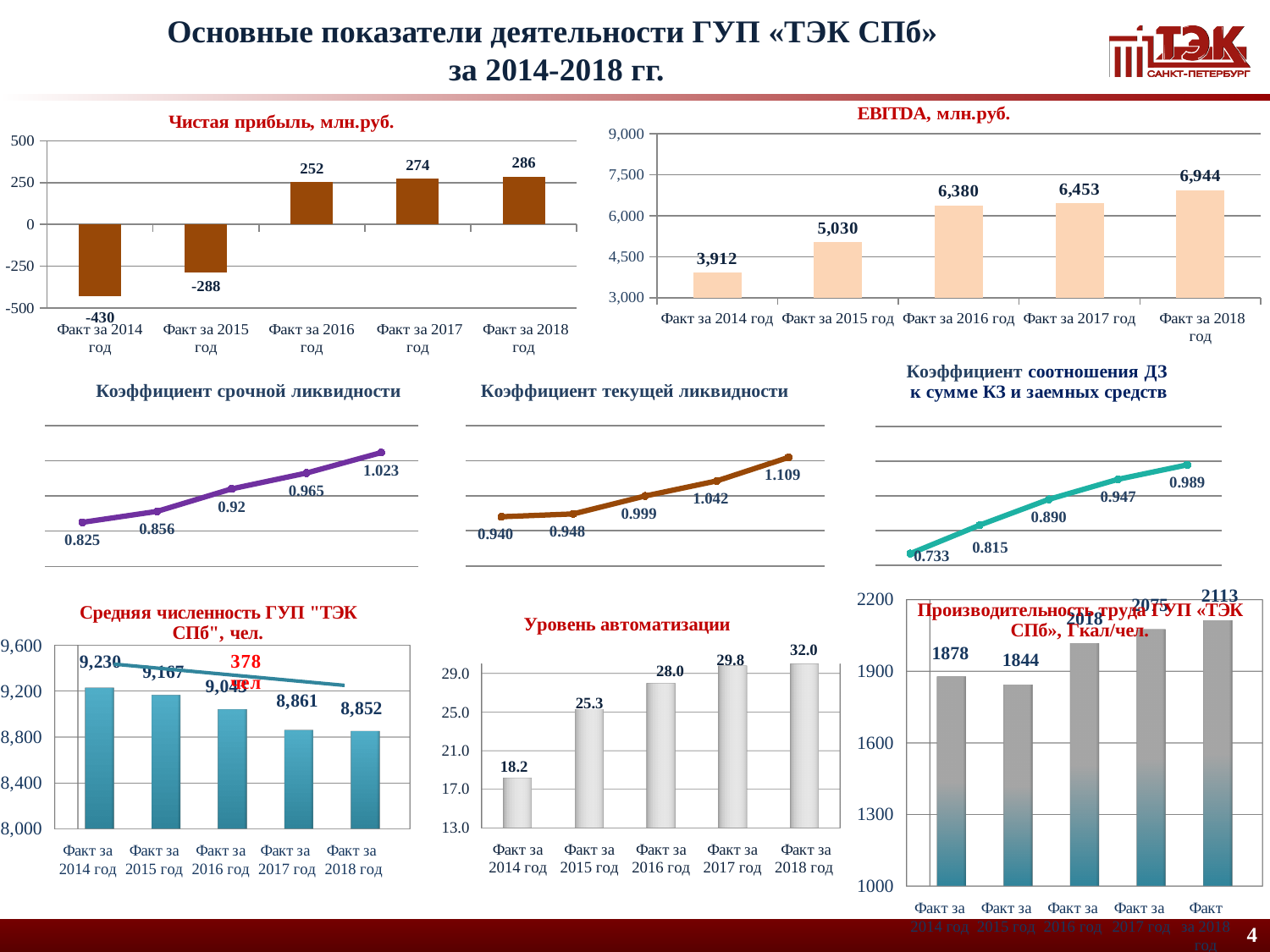
In the 'EBITDA, млн.руб.' chart, do the values rise or fall from 2014 to 2018? rise In the 'EBITDA, млн.руб.' chart, what is the difference between the values for Факт за 2018 год and Факт за 2014 год? 3,032 In the 'Производительность труда ГУП «ТЭК СПб», Гкал/чел.' chart, what is the value for Факт за 2015 год? 1844 In the 'Чистая прибыль, млн.руб.' chart, which year has the highest value? Факт за 2018 год In the 'Средняя численность ГУП "ТЭК СПб", чел.' chart, what is the value for Факт за 2017 год? 8,861 In the 'Коэффициент соотношения ДЗ к сумме КЗ и заемных средств' chart, what is the third value shown? 0.890 In the 'Чистая прибыль, млн.руб.' chart, what is the value for Факт за 2014 год? -430 In the 'Уровень автоматизации' chart, which is larger: the value for Факт за 2015 год or Факт за 2016 год? Факт за 2016 год What kind of chart is the 'Уровень автоматизации' chart? bar chart In the 'Коэффициент срочной ликвидности' chart, what is the last (2018) value? 1.023 In the 'EBITDA, млн.руб.' chart, what is the value for Факт за 2016 год? 6,380 In the 'Коэффициент текущей ликвидности' chart, what is the lowest value shown? 0.940